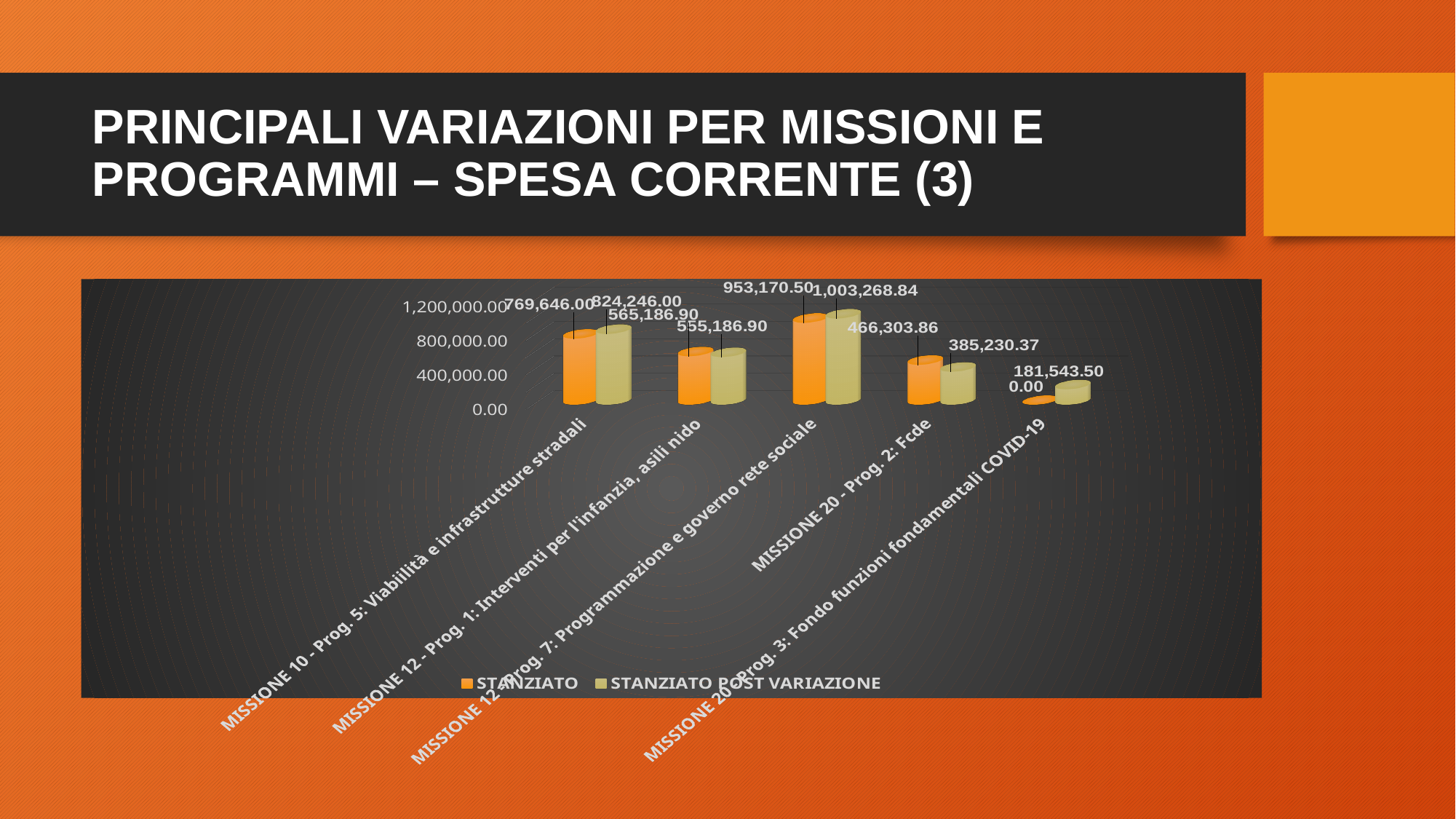
Which category has the lowest STANZIATO value? MISSIONE 20 - Prog. 3: Fondo funzioni fondamentali COVID-19 What kind of chart is shown on the slide? Bar chart How many categories are shown on the x axis of the chart? 5 For MISSIONE 12 - Prog. 1: Interventi per l'infanzia, asili nido, which is larger: STANZIATO or STANZIATO POST VARIAZIONE? STANZIATO What is the difference between the STANZIATO and STANZIATO POST VARIAZIONE values for MISSIONE 20 - Prog. 2: Fcde? 81,073.49 Which category has the highest STANZIATO POST VARIAZIONE value? MISSIONE 12 - Prog. 7: Programmazione e governo rete sociale How many series does the chart legend list? 2 What is the STANZIATO value for MISSIONE 20 - Prog. 3: Fondo funzioni fondamentali COVID-19? 0.00 What is the STANZIATO value for MISSIONE 12 - Prog. 7: Programmazione e governo rete sociale? 953,170.50 What is the STANZIATO POST VARIAZIONE value for MISSIONE 10 - Prog. 5: Viabilità e infrastrutture stradali? 824,246.00 What is the STANZIATO POST VARIAZIONE value for MISSIONE 20 - Prog. 2: Fcde? 385,230.37 What is the difference between the STANZIATO POST VARIAZIONE and STANZIATO values for MISSIONE 10 - Prog. 5: Viabilità e infrastrutture stradali? 54,600.00